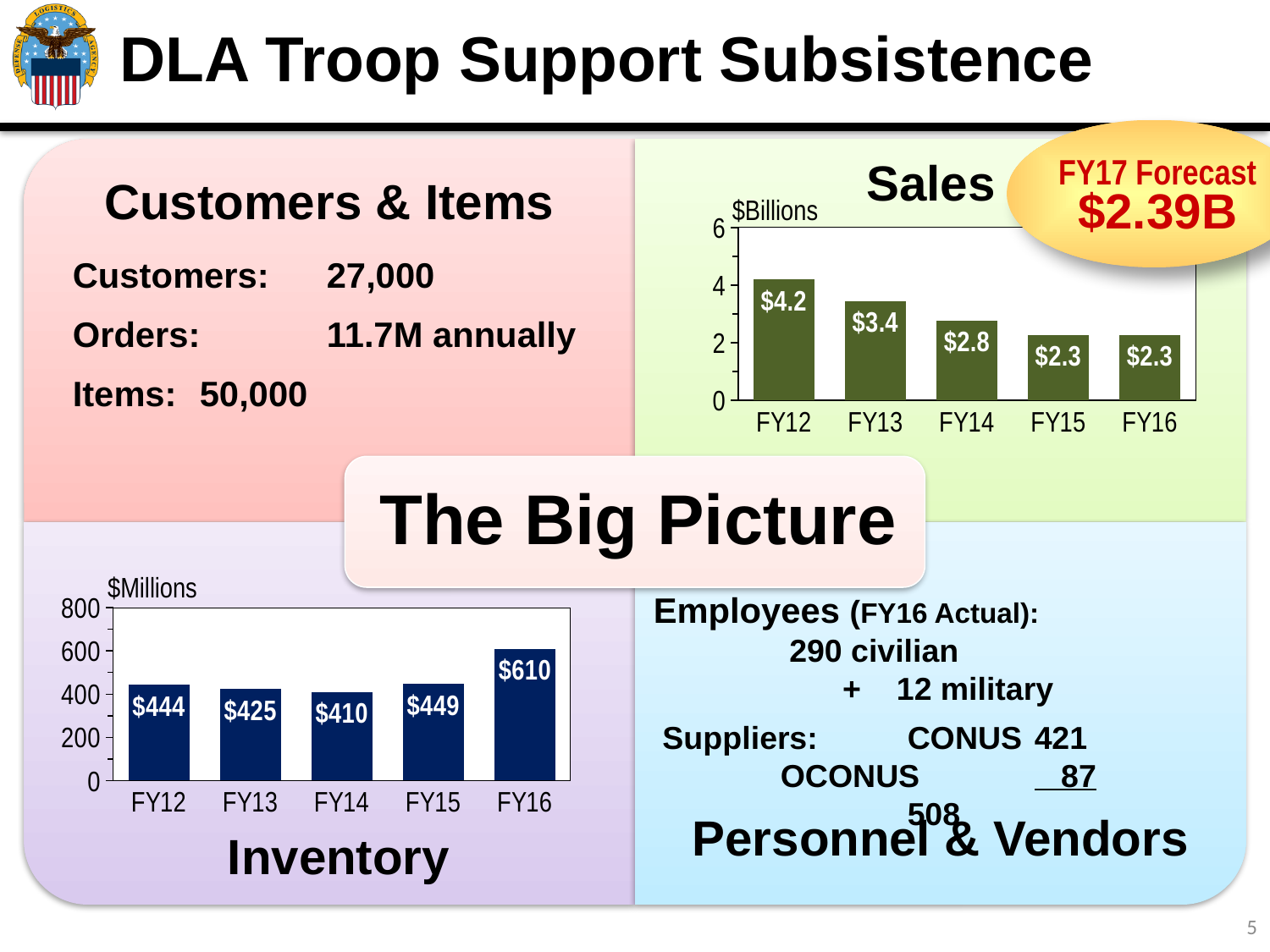
In the Inventory chart, which is larger, FY13 or FY15? FY15 In the Sales chart, what is the difference between FY12 and FY14? $1.4 In the Inventory chart, which fiscal year has the lowest inventory? FY14 In the Inventory chart, is the value for FY16 greater or less than 600? greater In the Inventory chart, what is the difference between FY16 and FY15? $161 In the Sales chart, what unit is shown above the axis? $Billions In the Inventory chart, what is the value for FY16? $610 What kind of chart is the Inventory chart? bar chart In the Sales chart, what is the value for FY12? $4.2 In the Sales chart, do sales rise or fall from FY12 to FY16? fall In the Sales chart, which fiscal year has the highest sales? FY12 In the Sales chart, how many fiscal years are plotted? 5